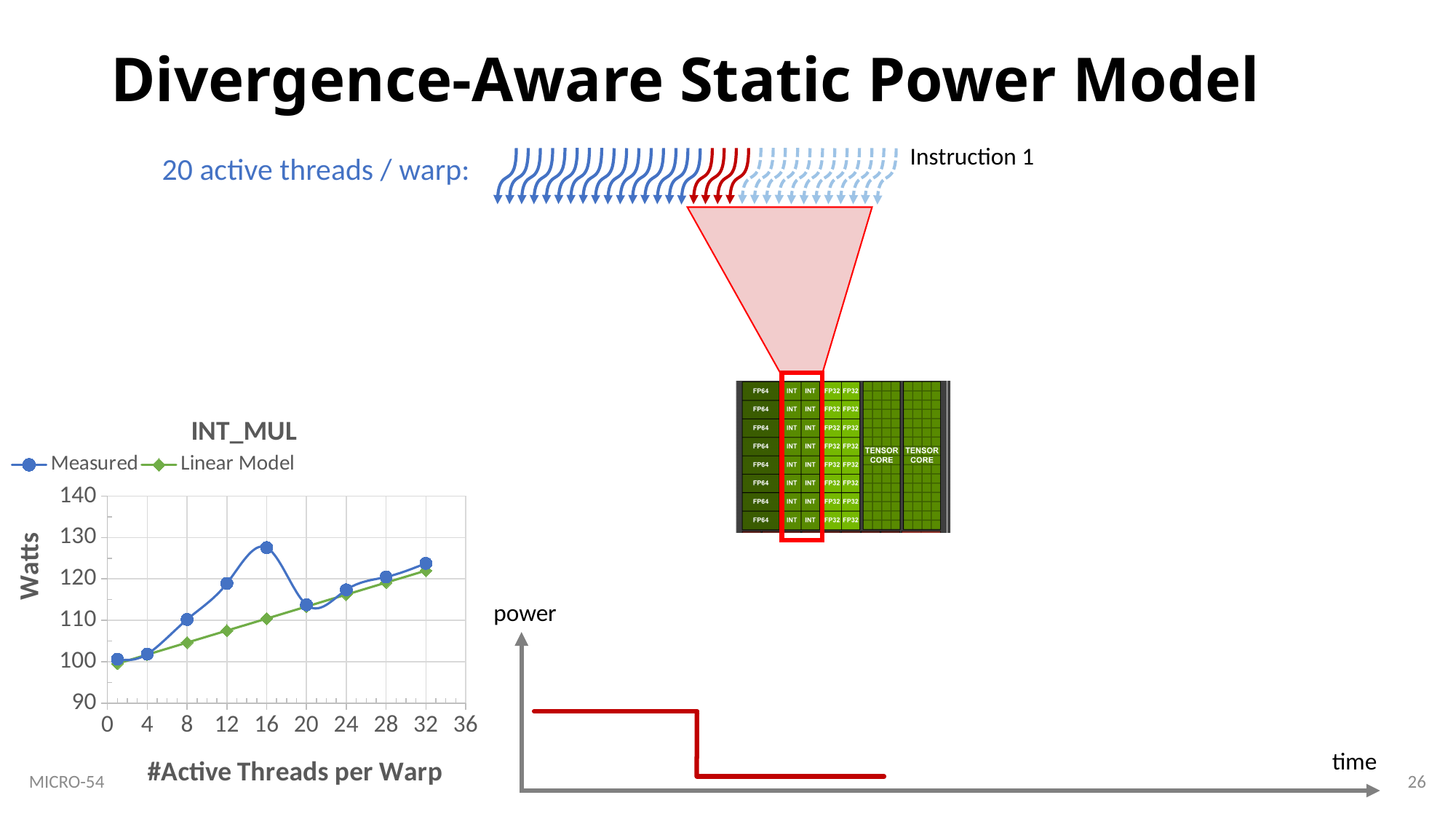
What is the label on the vertical axis of the INT_MUL chart? Watts In the INT_MUL chart, at 16 active threads per warp, which series has the larger value, Measured or Linear Model? Measured In the INT_MUL chart, is the Measured value at 16 active threads per warp greater or less than 120? greater In the INT_MUL chart, at which number of active threads per warp does the Measured series reach its highest value? 16 In the INT_MUL chart, does the Linear Model series rise or fall as the number of active threads per warp increases? rise What are the two series named in the legend of the INT_MUL chart? Measured and Linear Model How many data points does each series in the INT_MUL chart have? 9 How many series does the legend of the INT_MUL chart list? 2 In the INT_MUL chart, is the Measured value at 32 active threads per warp greater or less than 120? greater What kind of chart is the INT_MUL chart? line chart In the INT_MUL chart, is the Measured value at 8 active threads per warp greater or less than 120? less